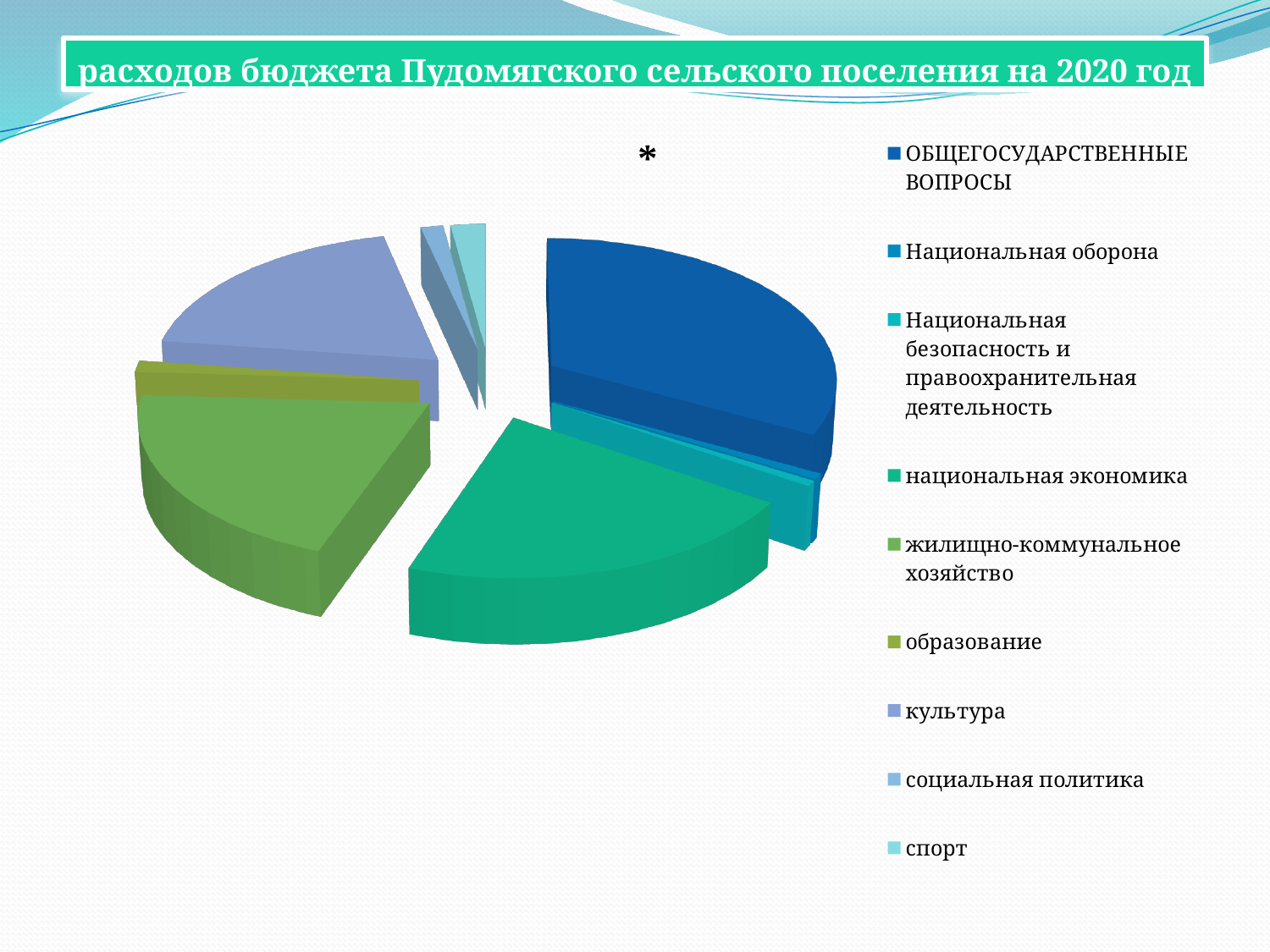
Which slice is larger: культура or Национальная оборона? культура Which category is the last entry in the legend? спорт What kind of chart is shown on the slide? pie chart Which slice is larger: национальная экономика or образование? национальная экономика Which slice is larger: ОБЩЕГОСУДАРСТВЕННЫЕ ВОПРОСЫ or культура? ОБЩЕГОСУДАРСТВЕННЫЕ ВОПРОСЫ Which category has the largest slice of the pie? ОБЩЕГОСУДАРСТВЕННЫЕ ВОПРОСЫ How many categories does the pie chart's legend list? 9 Which category is the first entry in the legend? ОБЩЕГОСУДАРСТВЕННЫЕ ВОПРОСЫ